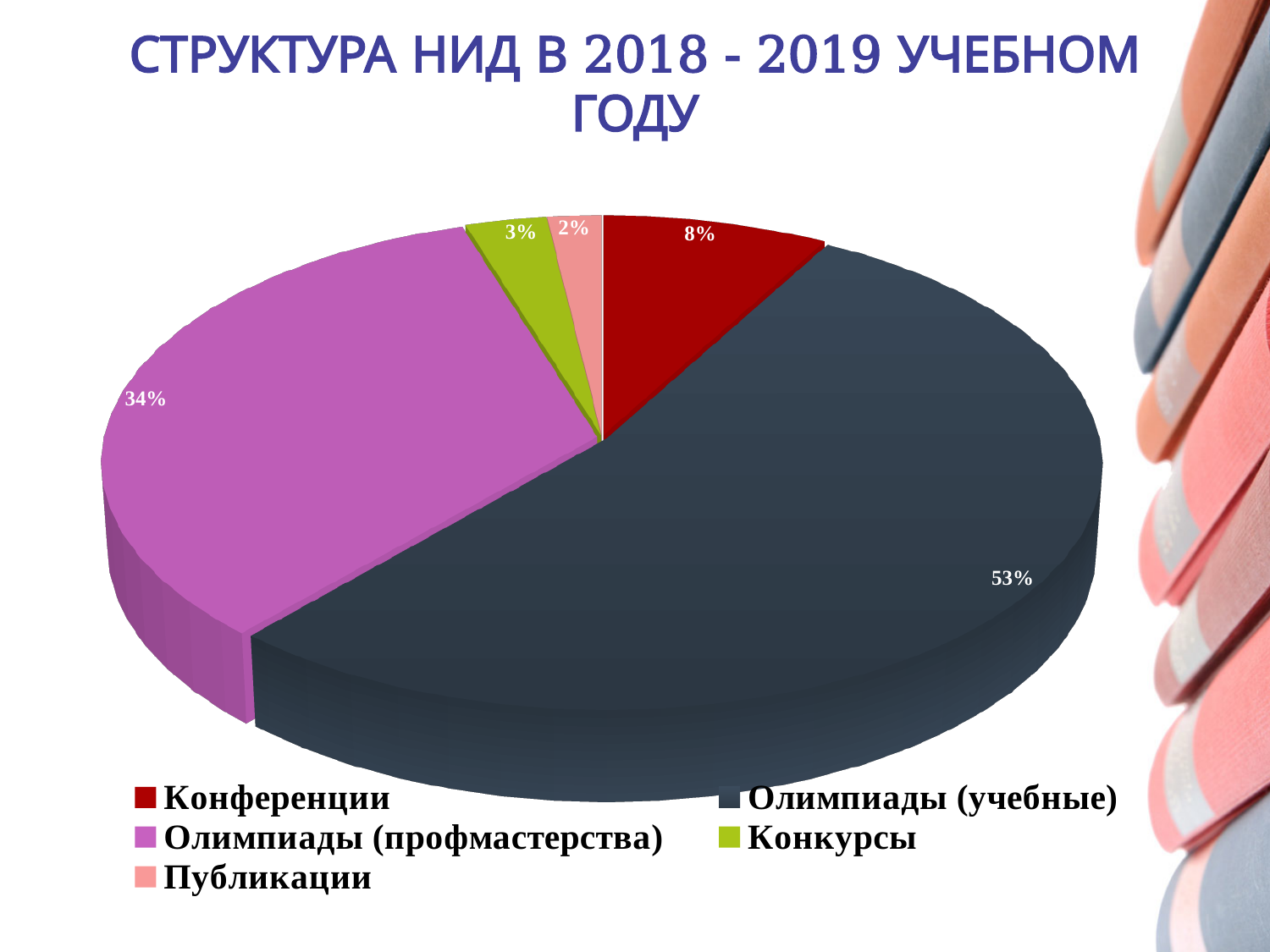
What kind of chart is shown on the slide? Pie chart What is the value shown for Публикации? 2% Which is larger, the share for Конференции or the share for Конкурсы? Конференции What is the value shown for Конференции? 8% How many categories does the pie chart show? 5 What is the title of the slide? СТРУКТУРА НИД В 2018 - 2019 УЧЕБНОМ ГОДУ What share of the pie does Олимпиады (учебные) have? 53% What is the value shown for Конкурсы? 3% Which category has the smallest slice of the pie? Публикации What is the difference between the shares of Олимпиады (учебные) and Олимпиады (профмастерства)? 19% What share of the pie does Олимпиады (профмастерства) have? 34% Which category has the largest slice of the pie? Олимпиады (учебные)